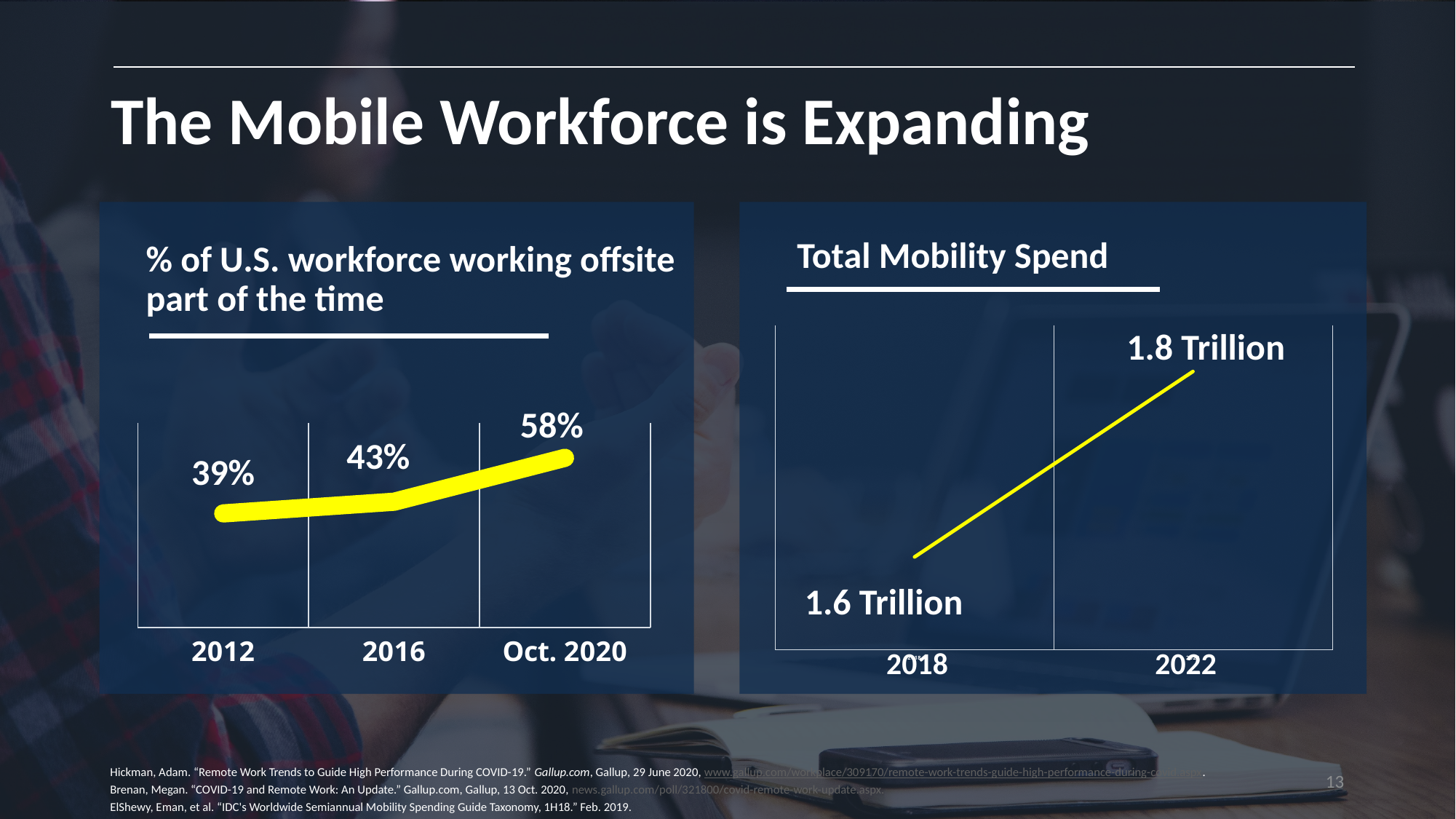
In the '% of U.S. workforce working offsite part of the time' chart, what is the difference between the Oct. 2020 value and the 2012 value? 19% In the '% of U.S. workforce working offsite part of the time' chart, do the values rise or fall from 2012 to Oct. 2020? rise In the '% of U.S. workforce working offsite part of the time' chart, what is the value for Oct. 2020? 58% In the '% of U.S. workforce working offsite part of the time' chart, which year has the highest value? Oct. 2020 In the '% of U.S. workforce working offsite part of the time' chart, what is the value for 2012? 39% In the 'Total Mobility Spend' chart, what is the value for 2022? 1.8 Trillion In the 'Total Mobility Spend' chart, which year has the larger value, 2018 or 2022? 2022 In the 'Total Mobility Spend' chart, what is the value for 2018? 1.6 Trillion In the '% of U.S. workforce working offsite part of the time' chart, which year has the lowest value? 2012 In the '% of U.S. workforce working offsite part of the time' chart, what is the value for 2016? 43% In the '% of U.S. workforce working offsite part of the time' chart, how many data points are plotted? 3 What kind of chart is the 'Total Mobility Spend' chart? line chart